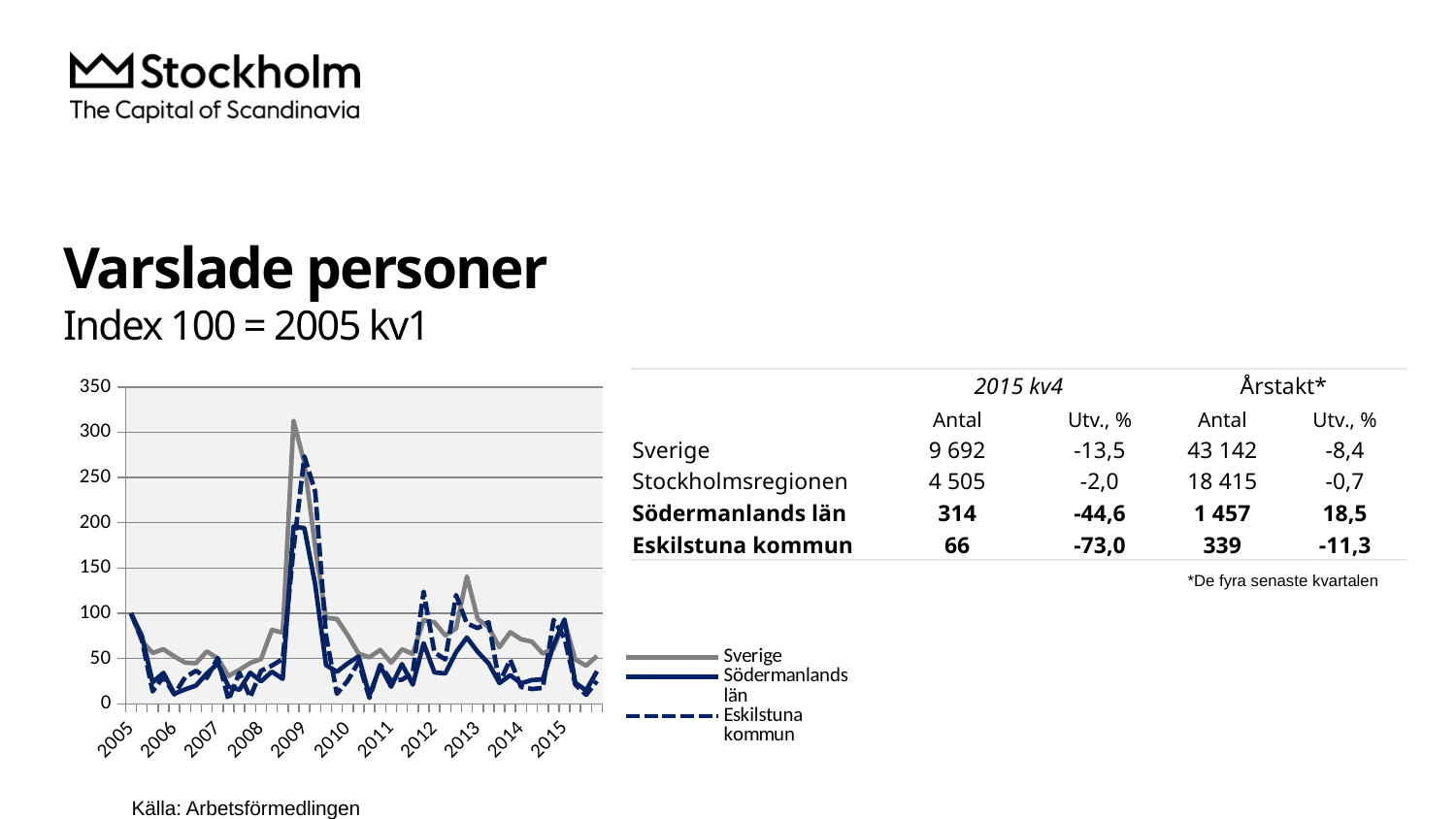
Which series is drawn with a dashed line? Eskilstuna kommun Which series reaches the highest peak on the chart? Sverige Is the peak value for Sverige around 2009 greater or less than 300? greater What is the index value of all three series at the start of the chart in 2005? 100 Is the value for Sverige at the end of 2015 greater or less than 100? less Which series are listed in the chart's legend? Sverige, Södermanlands län, Eskilstuna kommun How many series does the chart's legend list? 3 How many year labels are shown on the x axis? 11 Which series has the lowest peak around 2009? Södermanlands län Is the peak value for Södermanlands län around 2009 greater or less than 250? less What kind of chart is shown on the slide? line chart